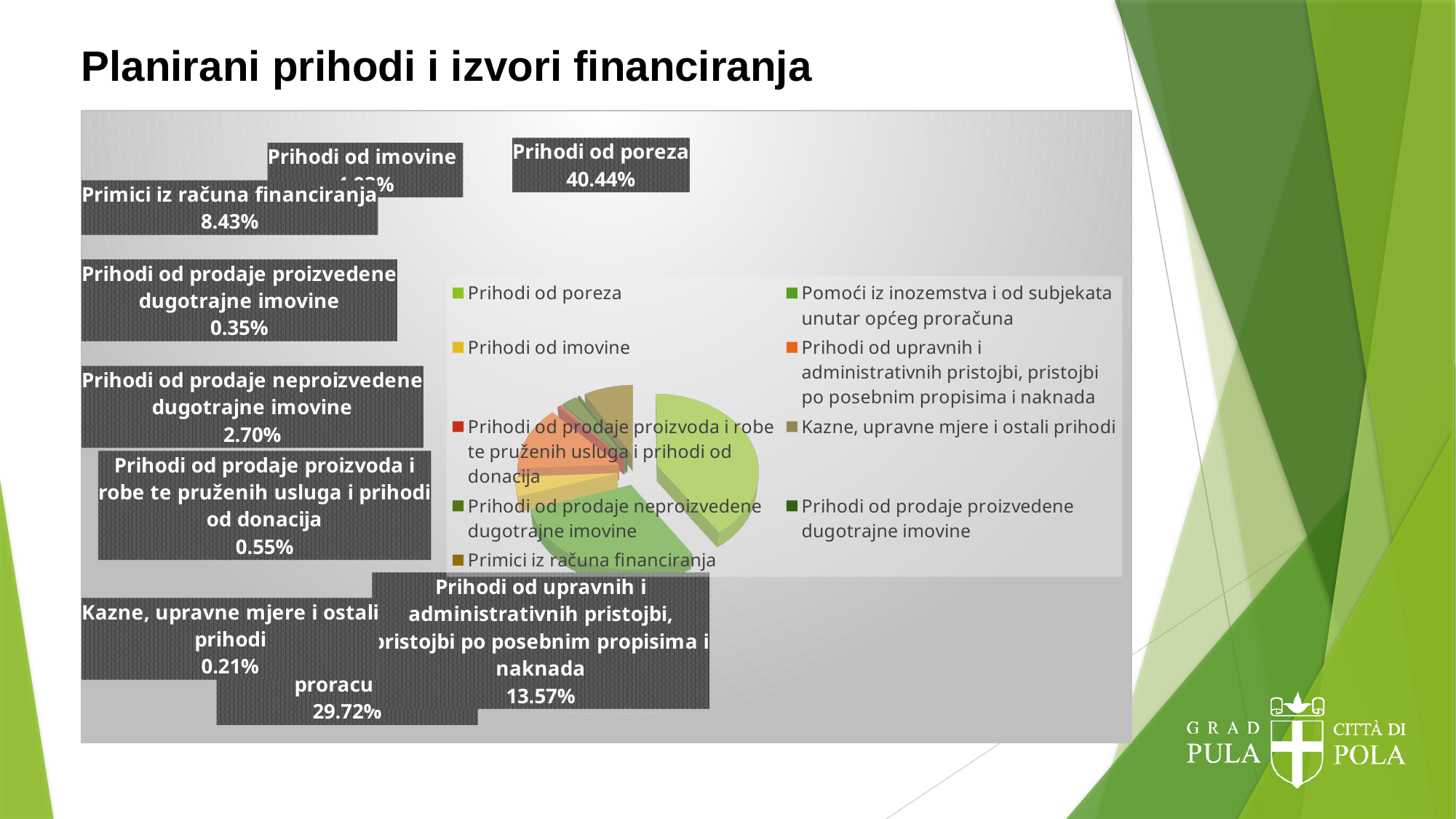
How many categories does the legend list? 9 Which category has the smallest share of the pie? Kazne, upravne mjere i ostali prihodi What share of planned revenue does Prihodi od poreza account for? 40.44% What type of chart is shown on the slide? Pie chart What percentage is shown for Prihodi od upravnih i administrativnih pristojbi, pristojbi po posebnim propisima i naknada? 13.57% Which is larger: Primici iz računa financiranja or Prihodi od prodaje neproizvedene dugotrajne imovine? Primici iz računa financiranja Which category has the largest share of the pie? Prihodi od poreza What percentage is shown for Prihodi od prodaje neproizvedene dugotrajne imovine? 2.70% What is the value shown for Primici iz računa financiranja? 8.43% How many percentage points larger is Prihodi od poreza than Prihodi od upravnih i administrativnih pristojbi, pristojbi po posebnim propisima i naknada? 26.87 percentage points What is the value for Prihodi od prodaje proizvedene dugotrajne imovine? 0.35% What is the value for Kazne, upravne mjere i ostali prihodi? 0.21%